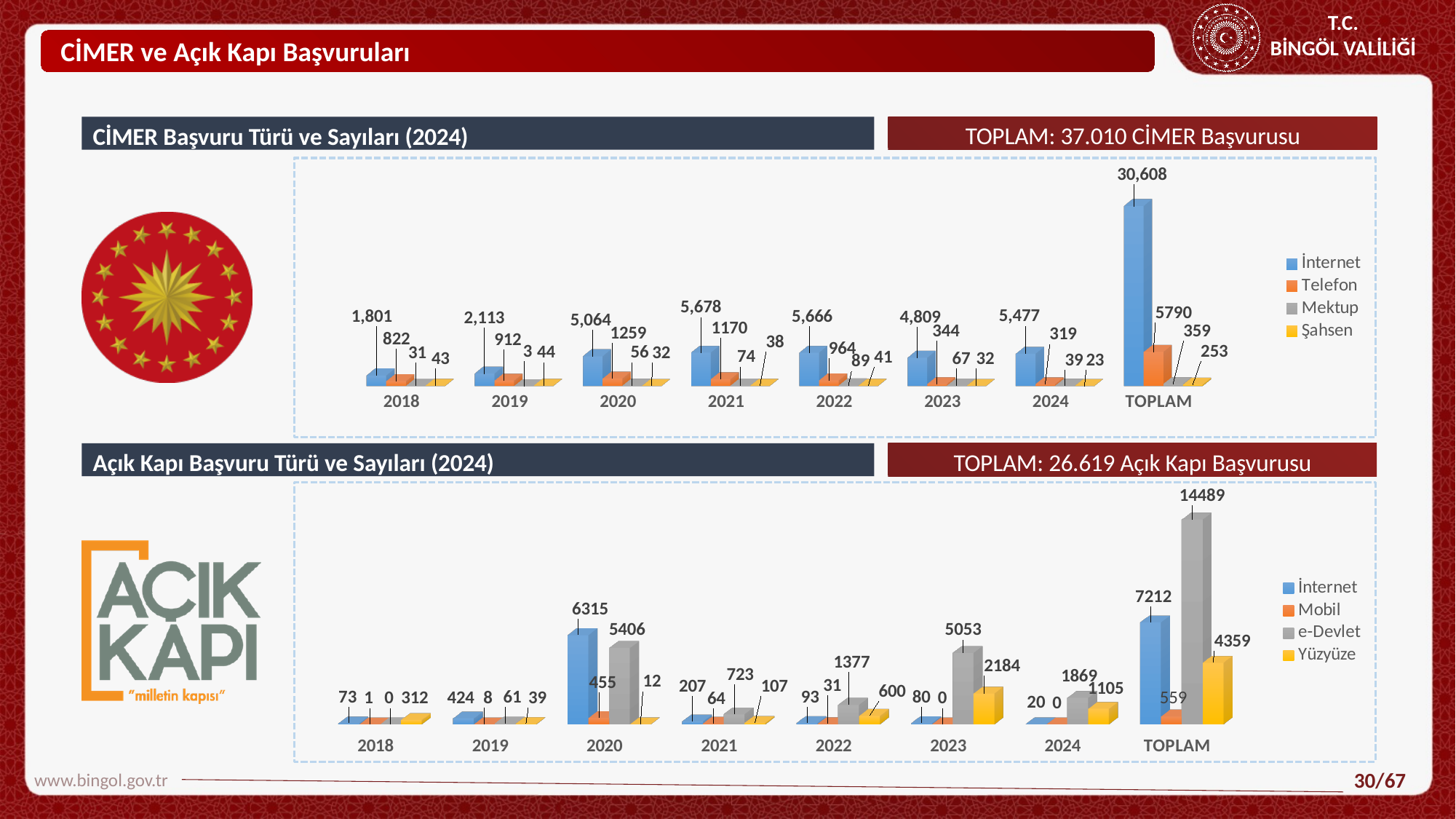
In the Açık Kapı Başvuru Türü ve Sayıları (2024) chart, which year has the highest İnternet value (excluding TOPLAM)? 2020 In the CİMER Başvuru Türü ve Sayıları (2024) chart, which year has the lowest Mektup value? 2019 In the CİMER Başvuru Türü ve Sayıları (2024) chart, what is the difference between the İnternet values for 2024 and 2023? 668 In the CİMER Başvuru Türü ve Sayıları (2024) chart, what is the İnternet value for 2021? 5,678 In the Açık Kapı Başvuru Türü ve Sayıları (2024) chart, what is the difference between the e-Devlet and Yüzyüze values for 2024? 764 How many categories are shown on the x axis of the Açık Kapı Başvuru Türü ve Sayıları (2024) chart? 8 In the Açık Kapı Başvuru Türü ve Sayıları (2024) chart, what is the e-Devlet value for 2023? 5053 In the CİMER Başvuru Türü ve Sayıları (2024) chart, what is the Telefon value for TOPLAM? 5790 What kind of chart is the Açık Kapı Başvuru Türü ve Sayıları (2024) chart? Bar chart In the Açık Kapı Başvuru Türü ve Sayıları (2024) chart, what is the Yüzyüze value for TOPLAM? 4359 In the CİMER Başvuru Türü ve Sayıları (2024) chart, which is larger for 2018: Telefon or Şahsen? Telefon In the CİMER Başvuru Türü ve Sayıları (2024) chart, how many series does the legend list? 4